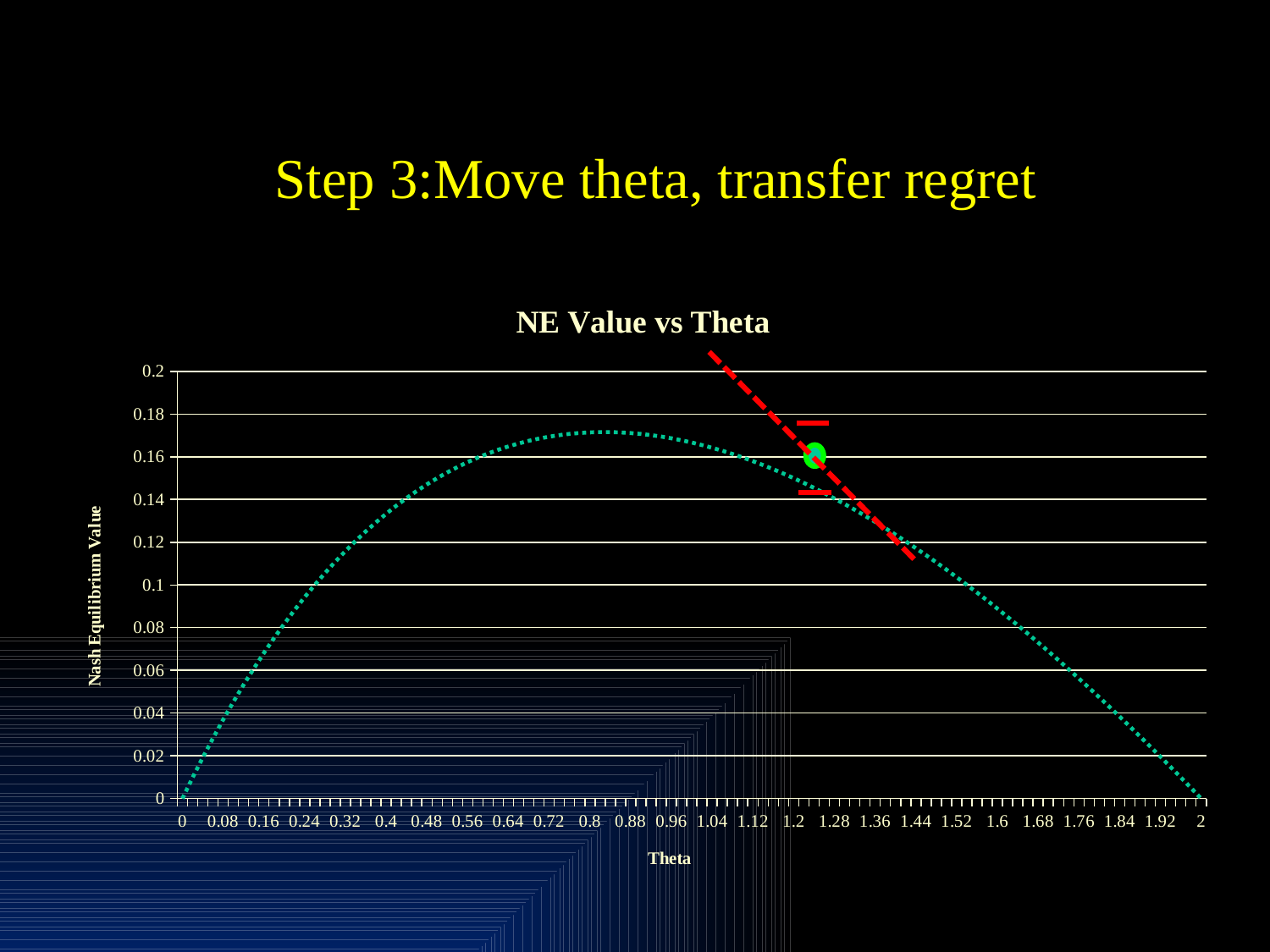
What kind of chart is shown on the slide? line chart Which has the larger Nash Equilibrium Value, Theta = 0.8 or Theta = 1.6? Theta = 0.8 Is the value for Theta = 0.16 greater or less than 0.08? less Does the Nash Equilibrium Value rise or fall as Theta increases from 0 to 0.8? rise What is the Nash Equilibrium Value at Theta = 2? 0 Is the value for Theta = 0.8 greater or less than 0.16? greater What is the label of the vertical axis of the chart? Nash Equilibrium Value Is the value for Theta = 1.76 greater or less than 0.08? less What is the Nash Equilibrium Value at Theta = 0? 0 Does the Nash Equilibrium Value rise or fall as Theta increases from 1.2 to 2? fall What is the title of the chart? NE Value vs Theta